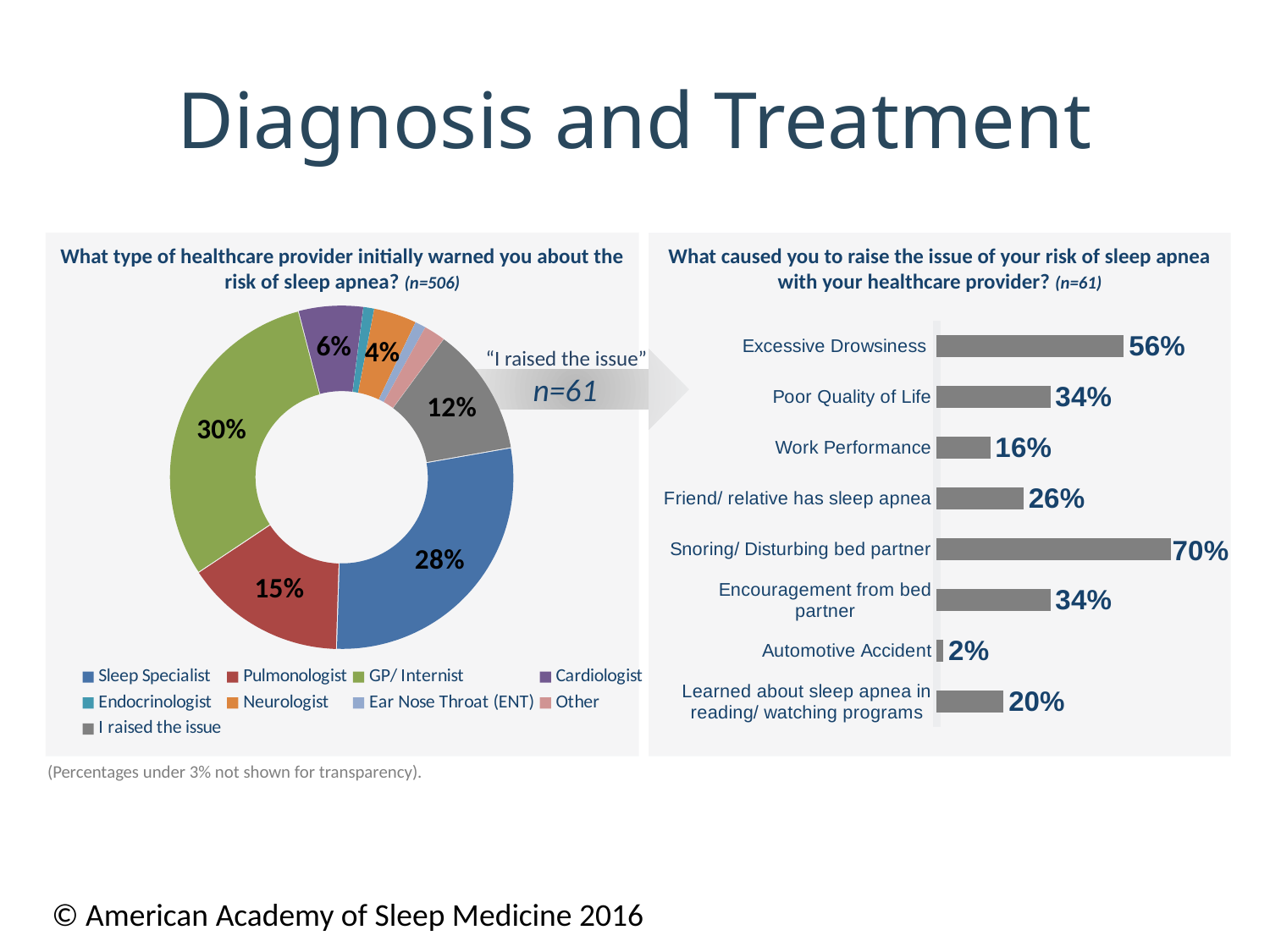
In the donut chart on the left, what share is labelled for GP/ Internist? 30% In the donut chart on the left, what share is labelled for Sleep Specialist? 28% What kind of chart is the chart on the right? Bar chart How many entries does the legend of the donut chart on the left list? 9 In the bar chart on the right, which is larger: Friend/ relative has sleep apnea or Learned about sleep apnea in reading/ watching programs? Friend/ relative has sleep apnea How many categories are shown in the bar chart on the right? 8 In the donut chart on the left, which is larger: Pulmonologist or I raised the issue? Pulmonologist In the bar chart on the right, which category has the lowest value? Automotive Accident In the bar chart on the right, which category has the highest value? Snoring/ Disturbing bed partner In the bar chart on the right, what is the value for Automotive Accident? 2% In the bar chart on the right, what is the value for Snoring/ Disturbing bed partner? 70% In the bar chart on the right, what is the difference between Excessive Drowsiness and Work Performance? 40%